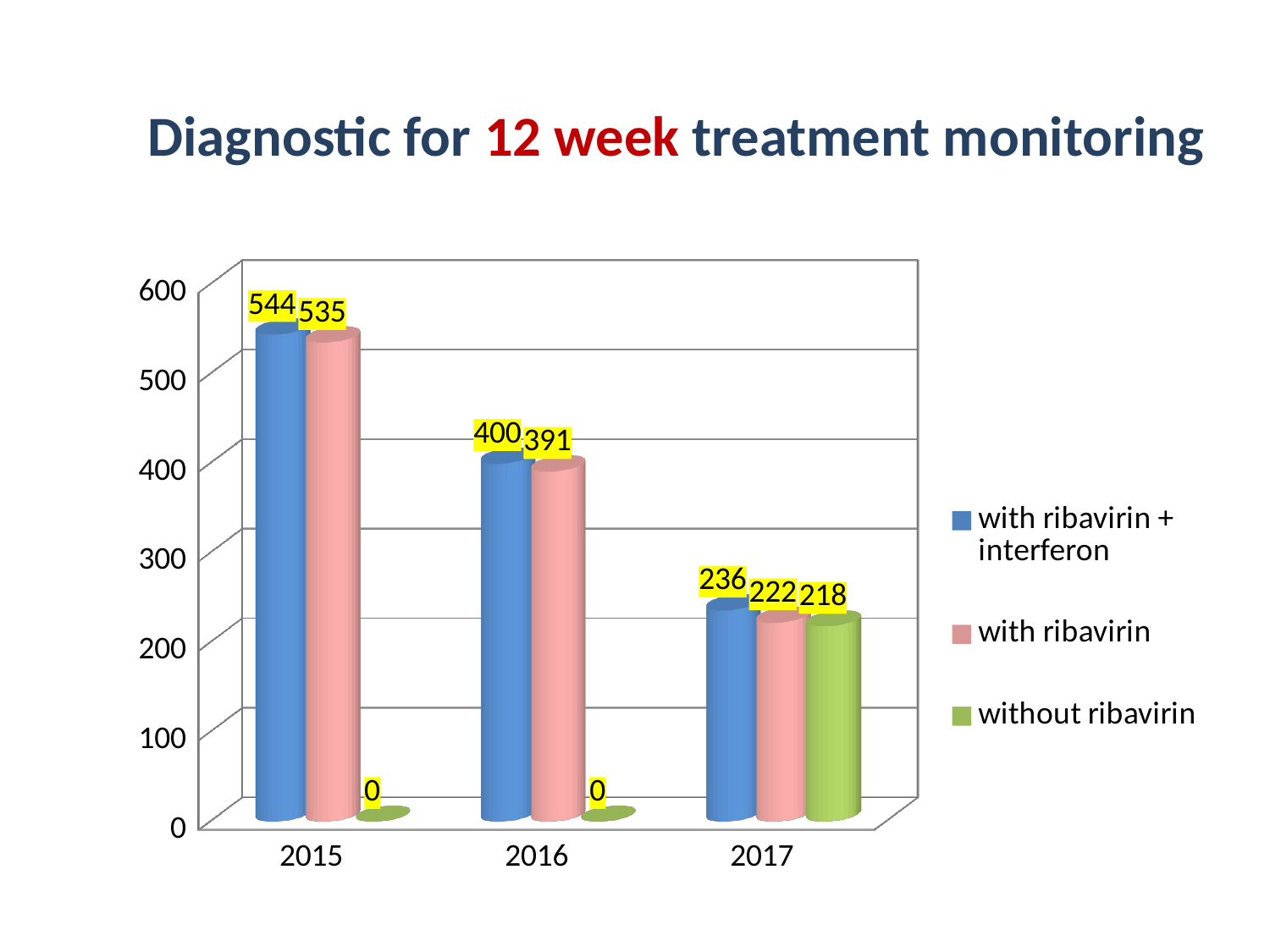
What is the difference between the 'with ribavirin + interferon' value and the 'with ribavirin' value in 2016? 9 How many years are shown on the x axis? 3 Which is larger in 2017: 'with ribavirin' or 'without ribavirin'? with ribavirin Which year has the lowest value for 'with ribavirin'? 2017 What is the value for 'without ribavirin' in 2015? 0 What is the value for 'without ribavirin' in 2017? 218 How many series does the legend list? 3 What is the value for 'with ribavirin' in 2016? 391 Do the 'with ribavirin + interferon' values rise or fall from 2015 to 2017? fall What kind of chart is shown on the slide? bar chart Which year has the highest value for 'with ribavirin + interferon'? 2015 What is the value for 'with ribavirin + interferon' in 2015? 544